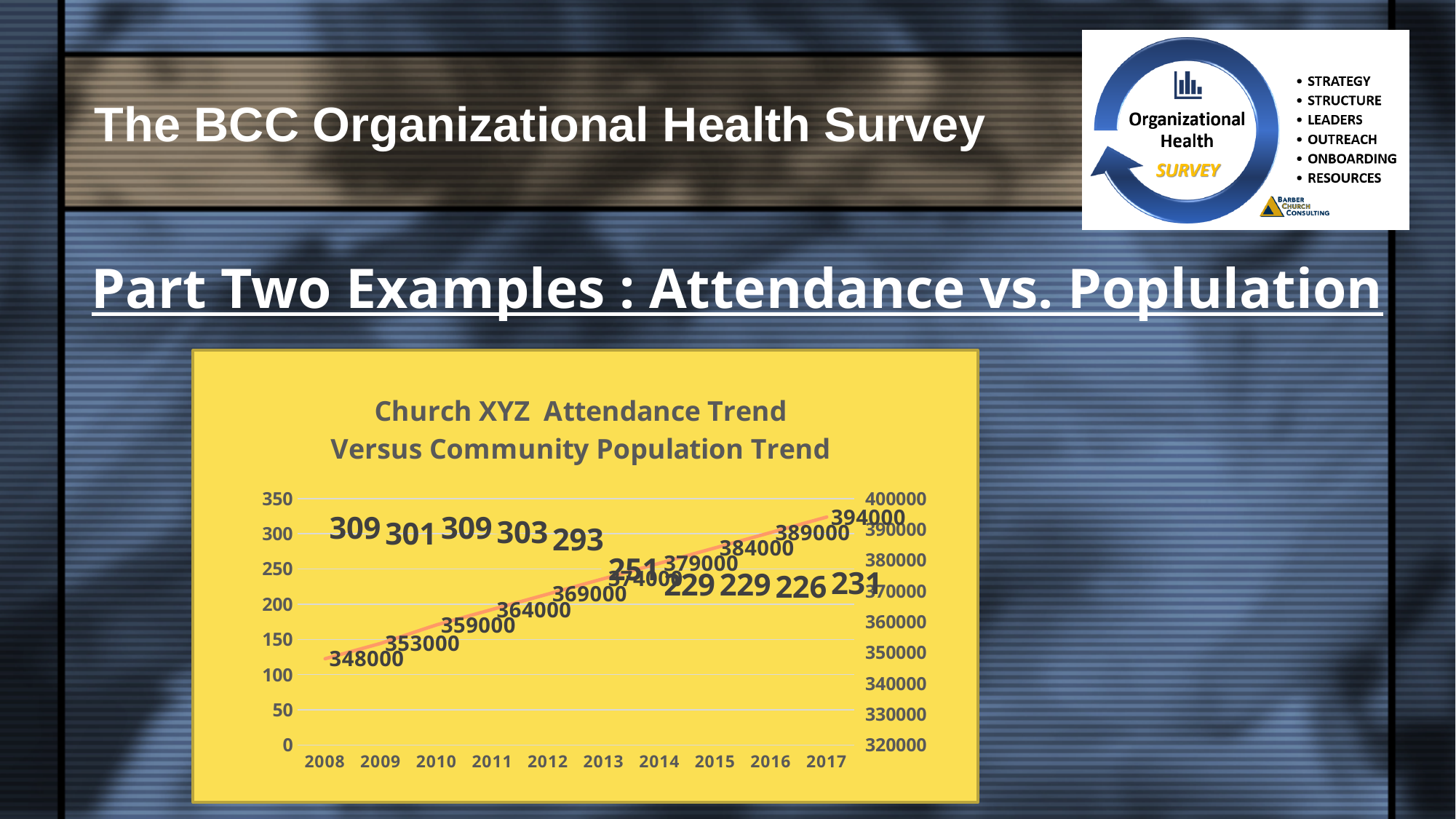
What is the community population value for 2017? 394000 What is the community population value for 2008? 348000 In which year is the community population value highest? 2017 What is the title of the chart on the slide? Church XYZ Attendance Trend Versus Community Population Trend In which year is the attendance value lowest? 2016 What is the attendance value for 2008? 309 What is the difference between the community population in 2017 and in 2008? 46000 Which is larger, the attendance in 2012 or the attendance in 2014? 2012 Does the community population rise or fall from 2008 to 2017? rise What is the difference between the attendance in 2008 and the attendance in 2017? 78 What is the attendance value for 2013? 251 How many years are shown on the x axis of the chart? 10